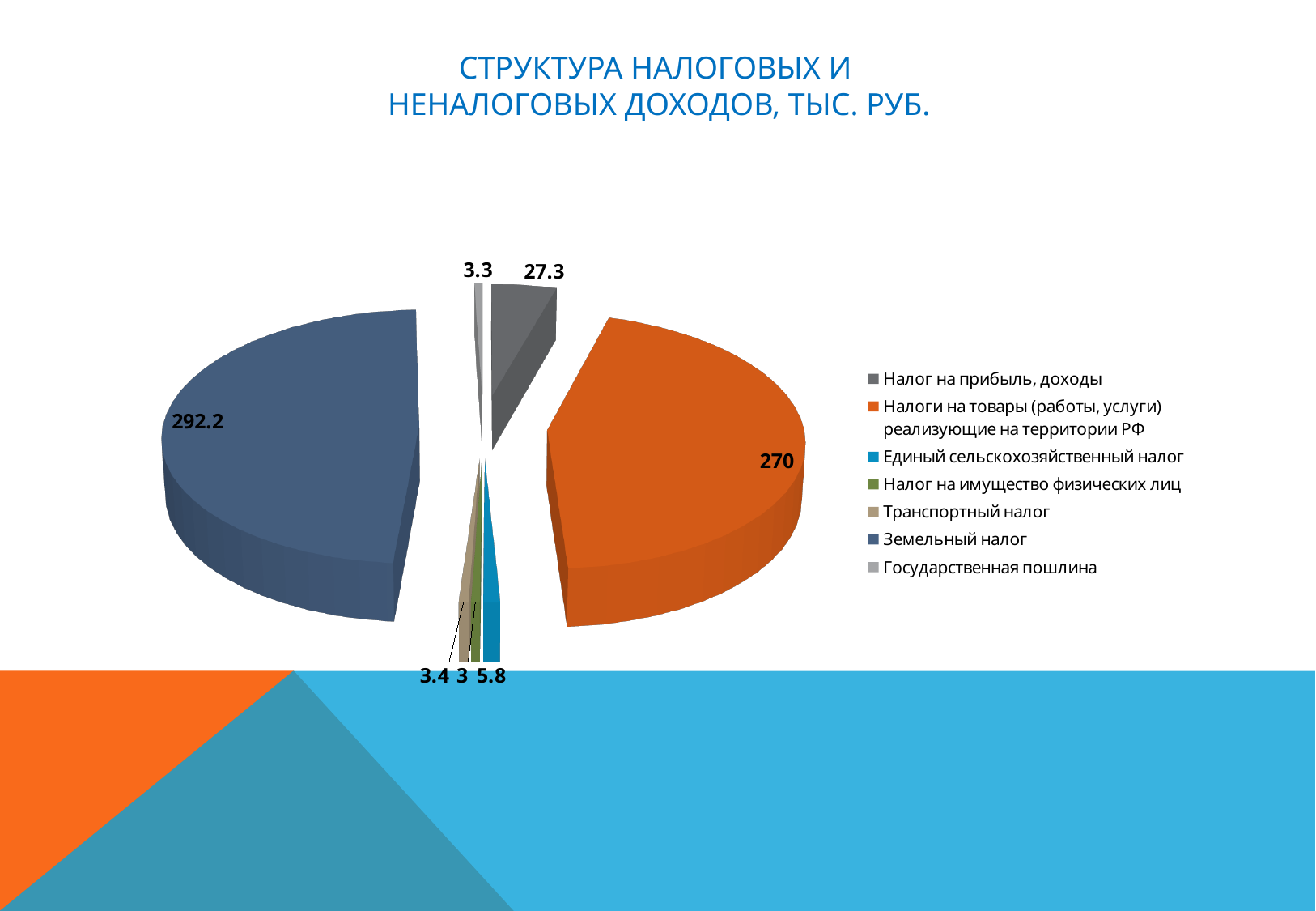
What is the value for Единый сельскохозяйственный налог? 5.8 How many categories does the legend list? 7 What is the value for Земельный налог? 292.2 What is the difference between the values for Земельный налог and Налоги на товары (работы, услуги) реализующие на территории РФ? 22.2 Which category has the smallest slice of the pie? Налог на имущество физических лиц Which category has the largest slice of the pie? Земельный налог What is the value for Государственная пошлина? 3.3 What is the value for Налог на прибыль, доходы? 27.3 What is the value for Налоги на товары (работы, услуги) реализующие на территории РФ? 270 Which is larger: Налог на прибыль, доходы or Единый сельскохозяйственный налог? Налог на прибыль, доходы What colour is the slice for Налоги на товары (работы, услуги) реализующие на территории РФ? Orange What type of chart is shown on the slide? Pie chart